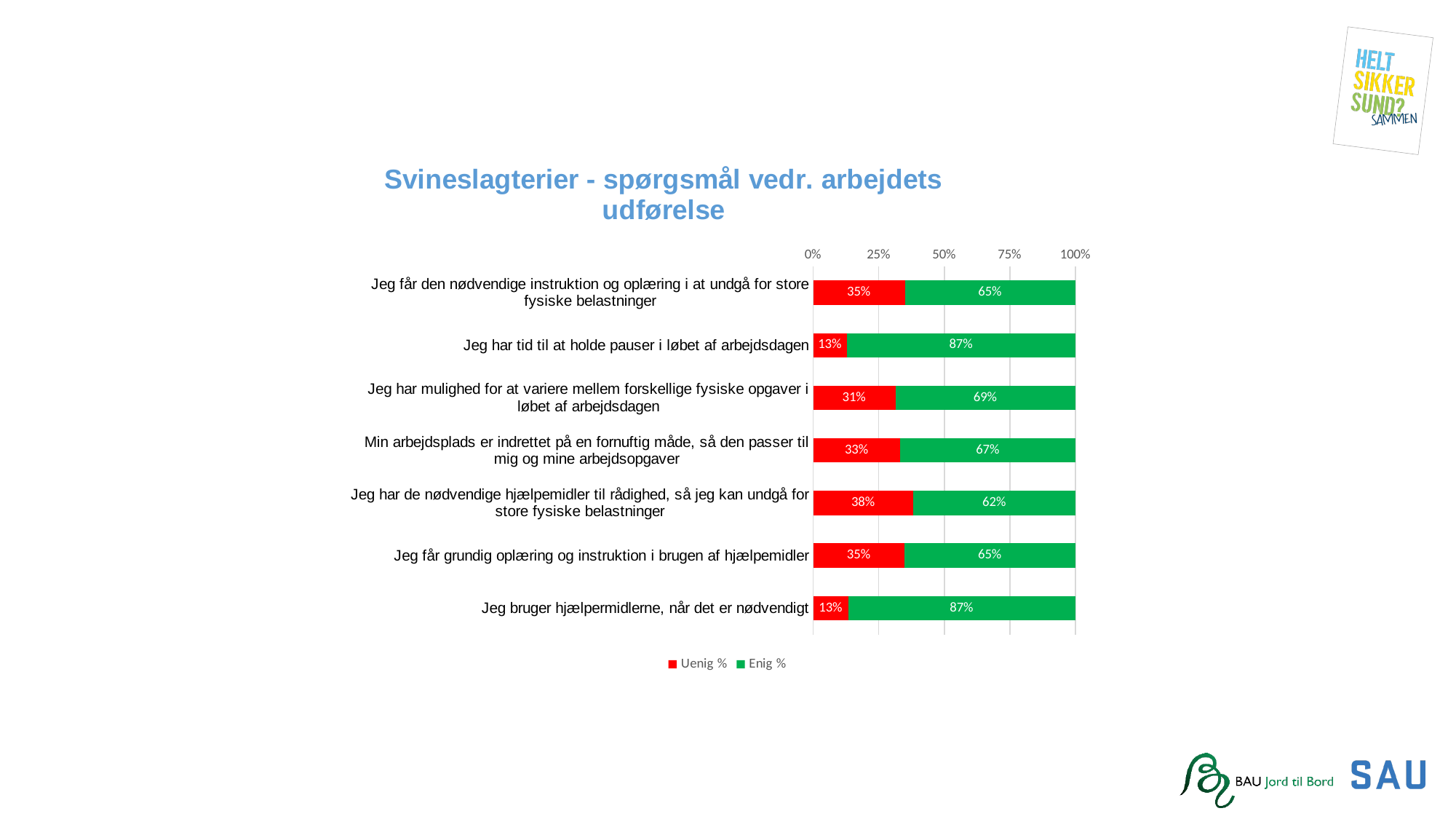
What is the total of the stacked bar for 'Jeg bruger hjælpermidlerne, når det er nødvendigt'? 100% Which is larger: the 'Uenig %' value for 'Jeg får grundig oplæring og instruktion i brugen af hjælpemidler' or for 'Jeg har mulighed for at variere mellem forskellige fysiske opgaver i løbet af arbejdsdagen'? Jeg får grundig oplæring og instruktion i brugen af hjælpemidler What is the 'Enig %' value for 'Jeg har de nødvendige hjælpemidler til rådighed, så jeg kan undgå for store fysiske belastninger'? 62% What is the 'Uenig %' value for 'Jeg har tid til at holde pauser i løbet af arbejdsdagen'? 13% How many statements (categories) are shown in the chart? 7 Which statement has the highest 'Uenig %' value? Jeg har de nødvendige hjælpemidler til rådighed, så jeg kan undgå for store fysiske belastninger Which statement has the lowest 'Enig %' value? Jeg har de nødvendige hjælpemidler til rådighed, så jeg kan undgå for store fysiske belastninger What is the title of the chart? Svineslagterier - spørgsmål vedr. arbejdets udførelse How many series does the legend list? 2 What is the 'Enig %' value for 'Jeg har mulighed for at variere mellem forskellige fysiske opgaver i løbet af arbejdsdagen'? 69% What is the difference between the 'Enig %' and 'Uenig %' values for 'Min arbejdsplads er indrettet på en fornuftig måde, så den passer til mig og mine arbejdsopgaver'? 34% What kind of chart is shown on the slide? Stacked bar chart